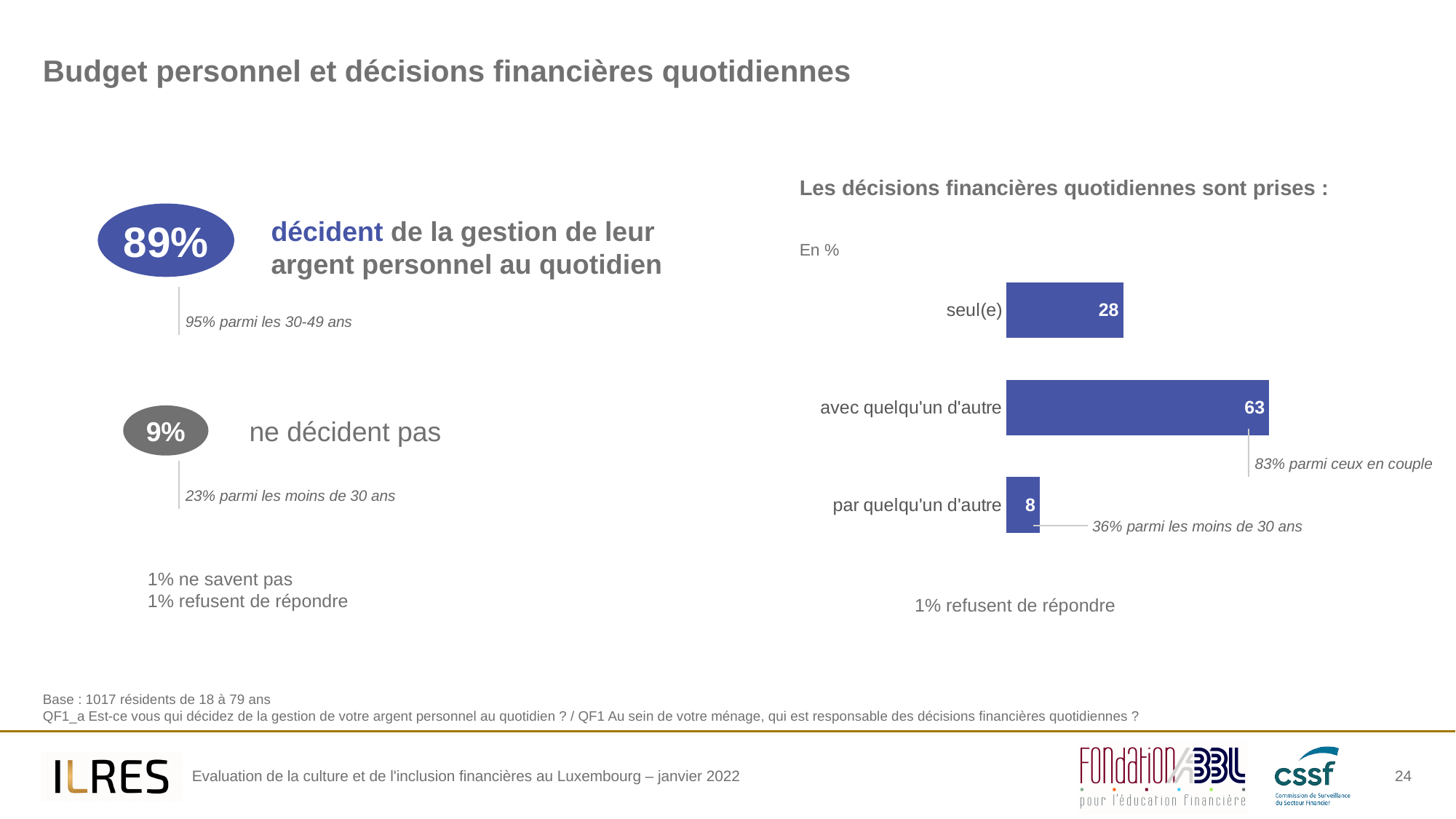
What unit is indicated for the values in the bar chart? En % What kind of chart is shown on the right of the slide? bar chart What is the difference between the values for "avec quelqu'un d'autre" and "seul(e)" in the bar chart? 35 What value is shown for "seul(e)" in the bar chart? 28 What value is shown for "par quelqu'un d'autre" in the bar chart? 8 What is the difference between the values for "seul(e)" and "par quelqu'un d'autre" in the bar chart? 20 Which is larger in the bar chart: the value for "seul(e)" or the value for "par quelqu'un d'autre"? seul(e) What value is shown for "avec quelqu'un d'autre" in the bar chart? 63 What is the title of the bar chart on the slide? Les décisions financières quotidiennes sont prises : How many categories are shown in the bar chart? 3 Which category has the lowest value in the bar chart? par quelqu'un d'autre Which category has the highest value in the bar chart? avec quelqu'un d'autre